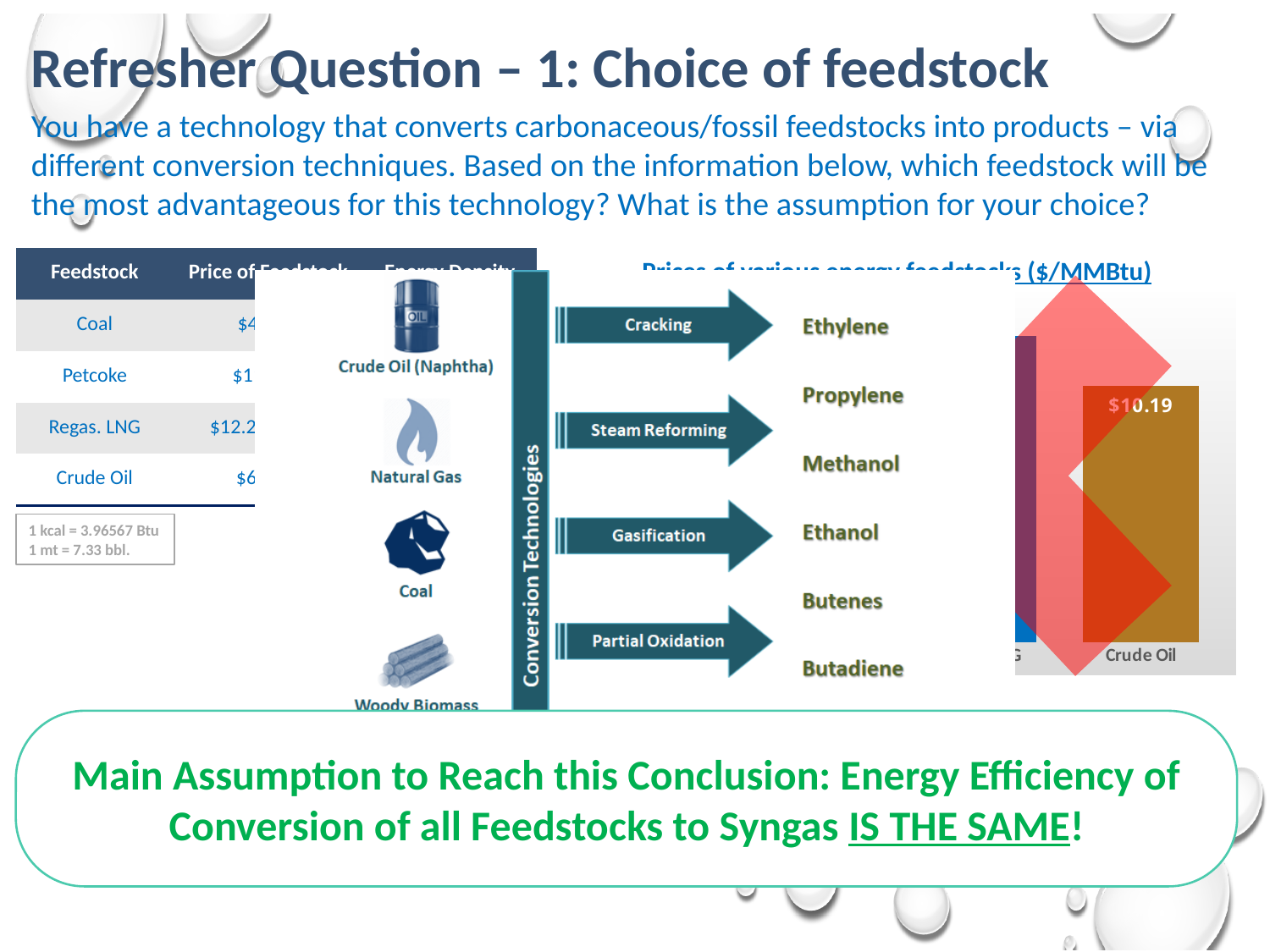
In what units are the values of the bar chart on the right of the slide expressed, according to its heading? $/MMBtu Which category label is readable on the x axis of the bar chart on the right of the slide? Crude Oil In the bar chart on the right of the slide, what is the value labelled for Crude Oil? $10.19 What kind of chart is shown on the right side of the slide, under the heading ending in "($/MMBtu)"? bar chart